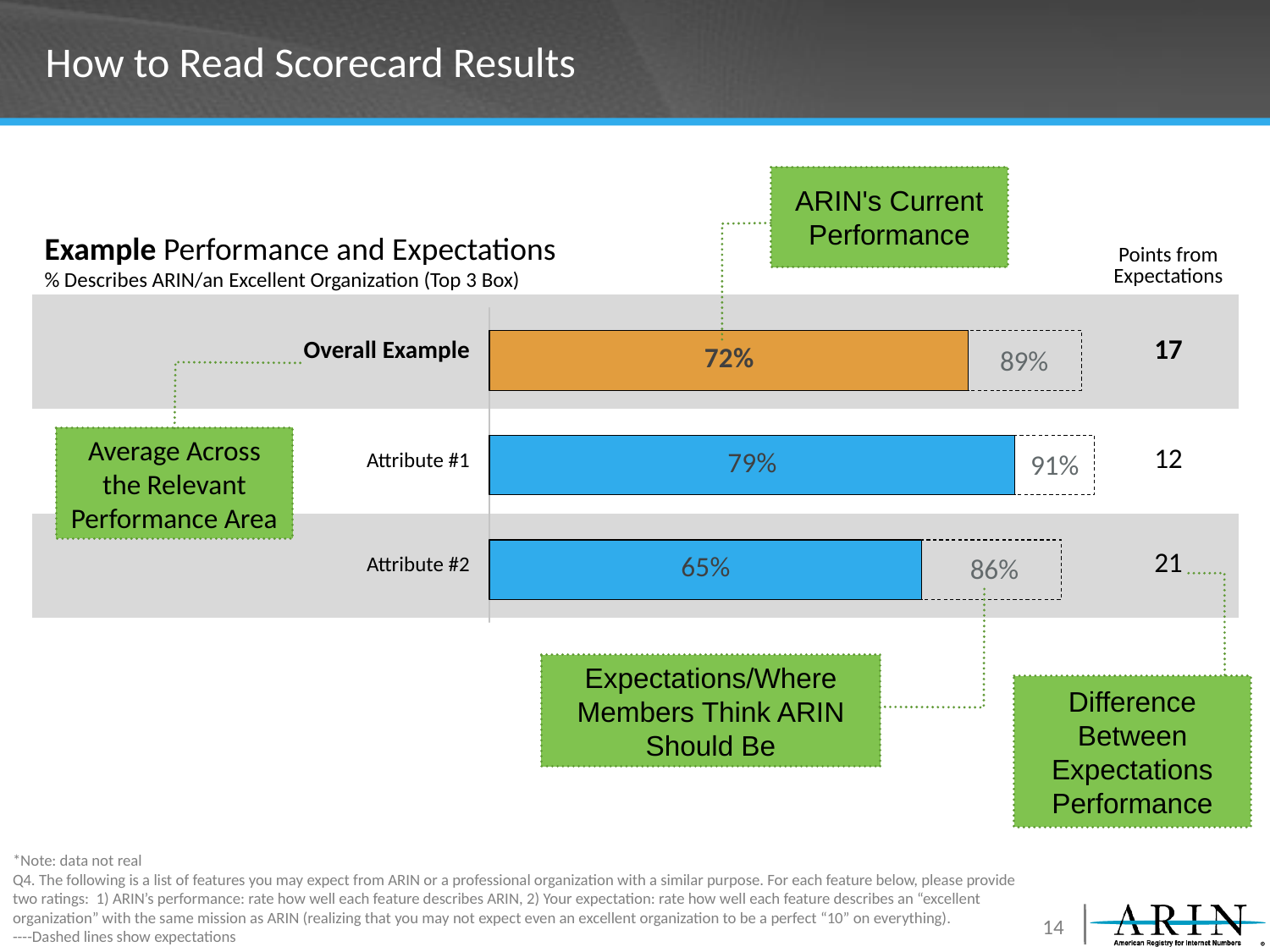
Which is larger, the performance value for Attribute #1 or for Attribute #2? Attribute #1 How many points from expectations is Attribute #2? 21 What is the expectations value for Attribute #1? 91% What kind of chart is shown on the slide? Bar chart Which category has the lowest current performance value? Attribute #2 What is the performance value for Overall Example? 72% What is ARIN's current performance value for Attribute #1? 79% How many categories are shown in the chart? 3 What is the difference between the expectations value and the performance value for Overall Example? 17 According to the slide, what do the dashed lines show? Expectations Which category has the highest current performance value? Attribute #1 What is the expectations value for Attribute #2? 86%